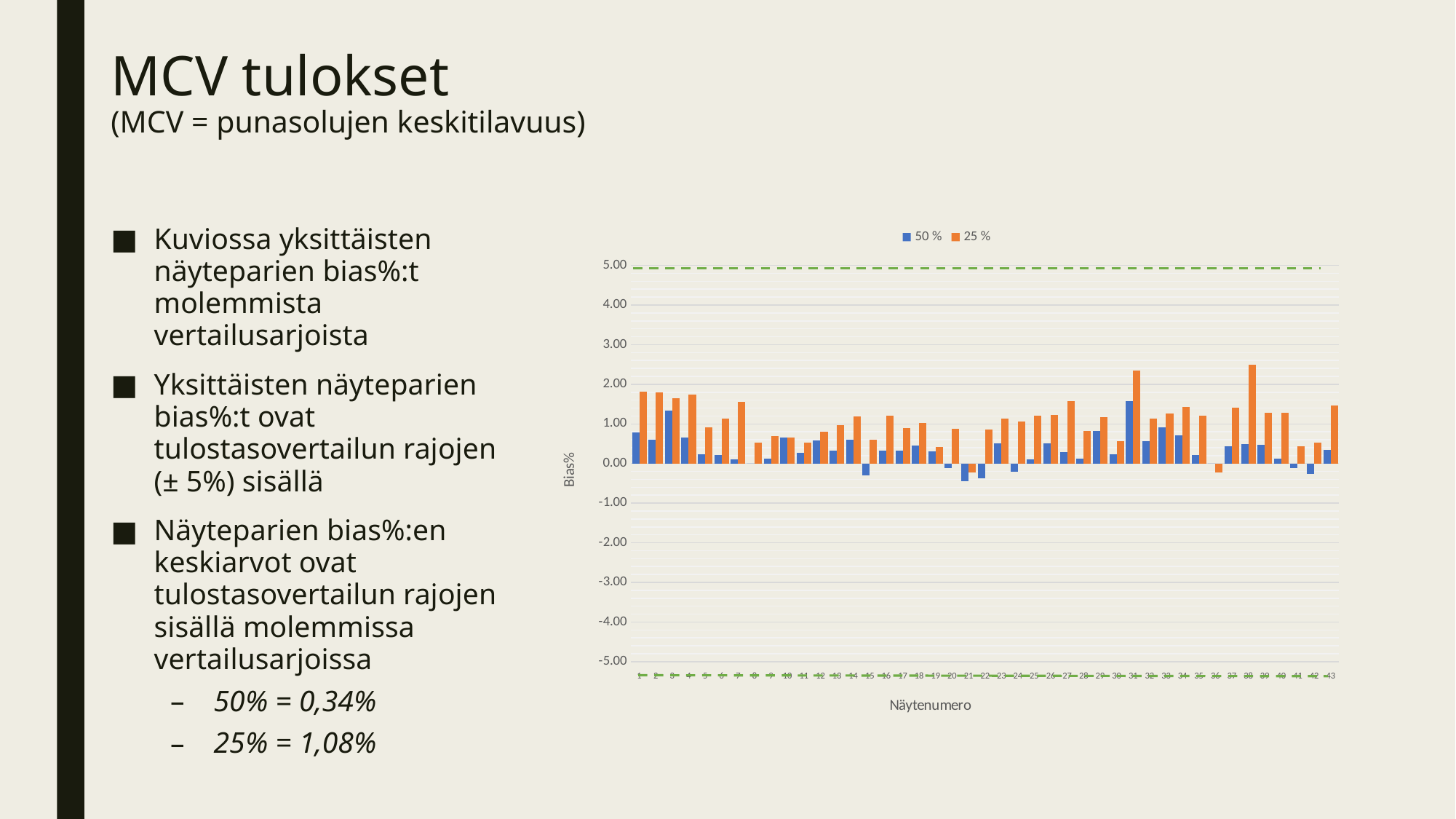
How many sample numbers (categories) are plotted along the x axis of the chart? 43 What kind of chart is shown on the slide? bar chart Is the 50 % series value for sample 21 greater or less than 0.00? less How many series does the chart legend list? 2 What are the two series named in the chart legend? 50 % and 25 % What is the title of the chart's vertical axis? Bias% For sample 31, which series has the larger bias%: 50 % or 25 %? 25 % Is the 25 % series value for sample 31 greater or less than 2.00? greater Is the 25 % series value for sample 38 greater or less than 2.00? greater For sample 1, which series has the larger bias%: 50 % or 25 %? 25 %